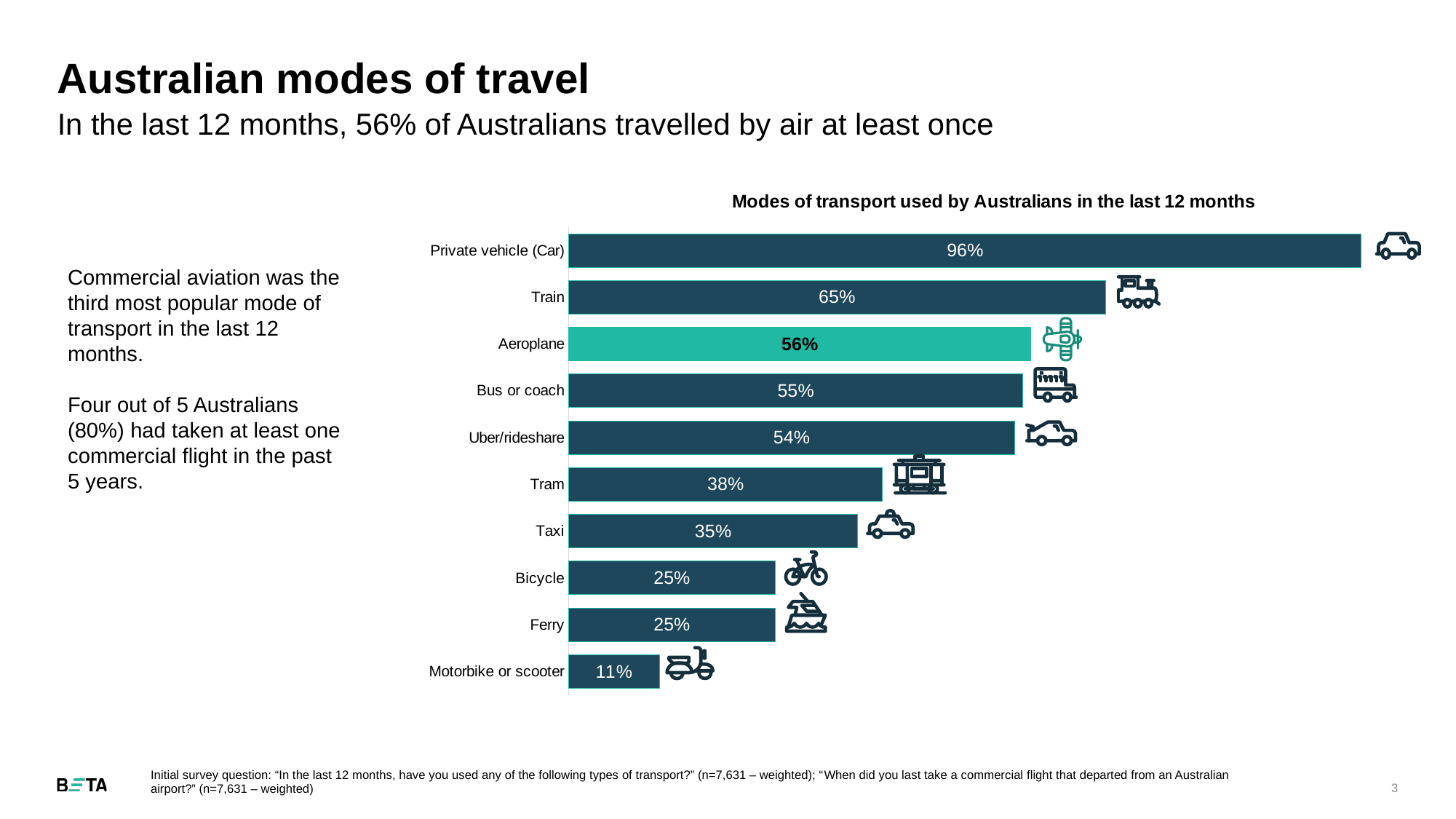
Which mode of transport has the lowest value in the chart? Motorbike or scooter What is the title of the chart? Modes of transport used by Australians in the last 12 months What is the difference between the values for Tram and Taxi? 3% What percentage of Australians used a private vehicle (car) in the last 12 months? 96% What is the value shown for Aeroplane? 56% How many modes of transport are shown in the chart? 10 What kind of chart is shown on the slide? Bar chart Which has a larger value, Train or Bus or coach? Train What percentage is shown for Uber/rideshare? 54% What is the difference between the values for Train and Aeroplane? 9% Which mode of transport has the highest value in the chart? Private vehicle (Car) Which has a larger value, Taxi or Bicycle? Taxi